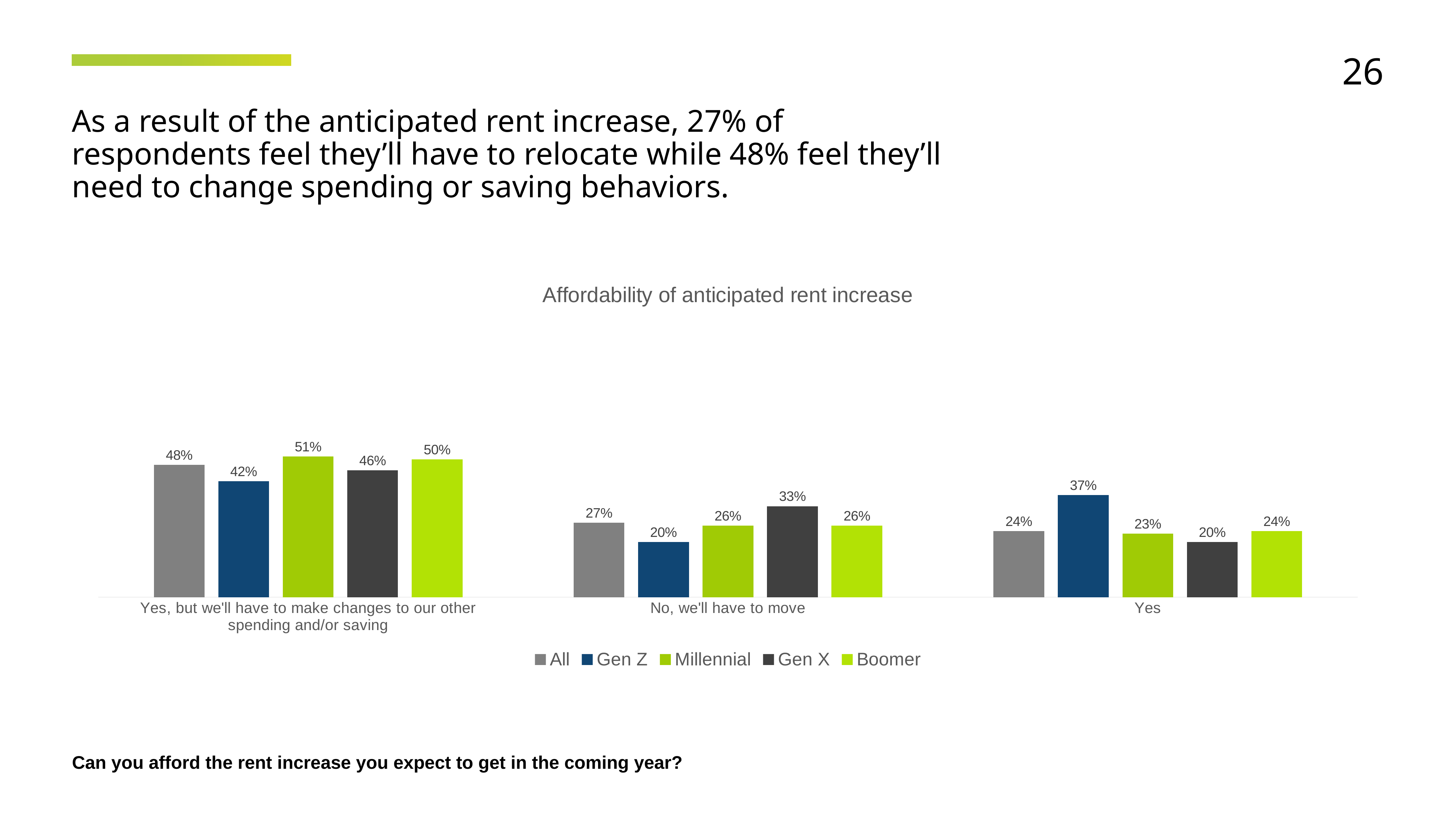
Which series has the highest value in the "No, we'll have to move" category? Gen X What kind of chart is shown on the slide? Bar chart What is the difference between the Gen Z and Gen X values in the "Yes" category? 17% What is the value for Gen X in the "Yes" category? 20% Which series has the lowest value in the "Yes, but we'll have to make changes to our other spending and/or saving" category? Gen Z What is the value for Boomer in the "Yes, but we'll have to make changes to our other spending and/or saving" category? 50% What is the value for Millennial in the "Yes, but we'll have to make changes to our other spending and/or saving" category? 51% How many categories are shown on the x axis? 3 Which is larger in the "No, we'll have to move" category: the value for All or the value for Gen X? Gen X What is the title of the chart? Affordability of anticipated rent increase What is the value for Gen Z in the "No, we'll have to move" category? 20% How many series does the legend list? 5